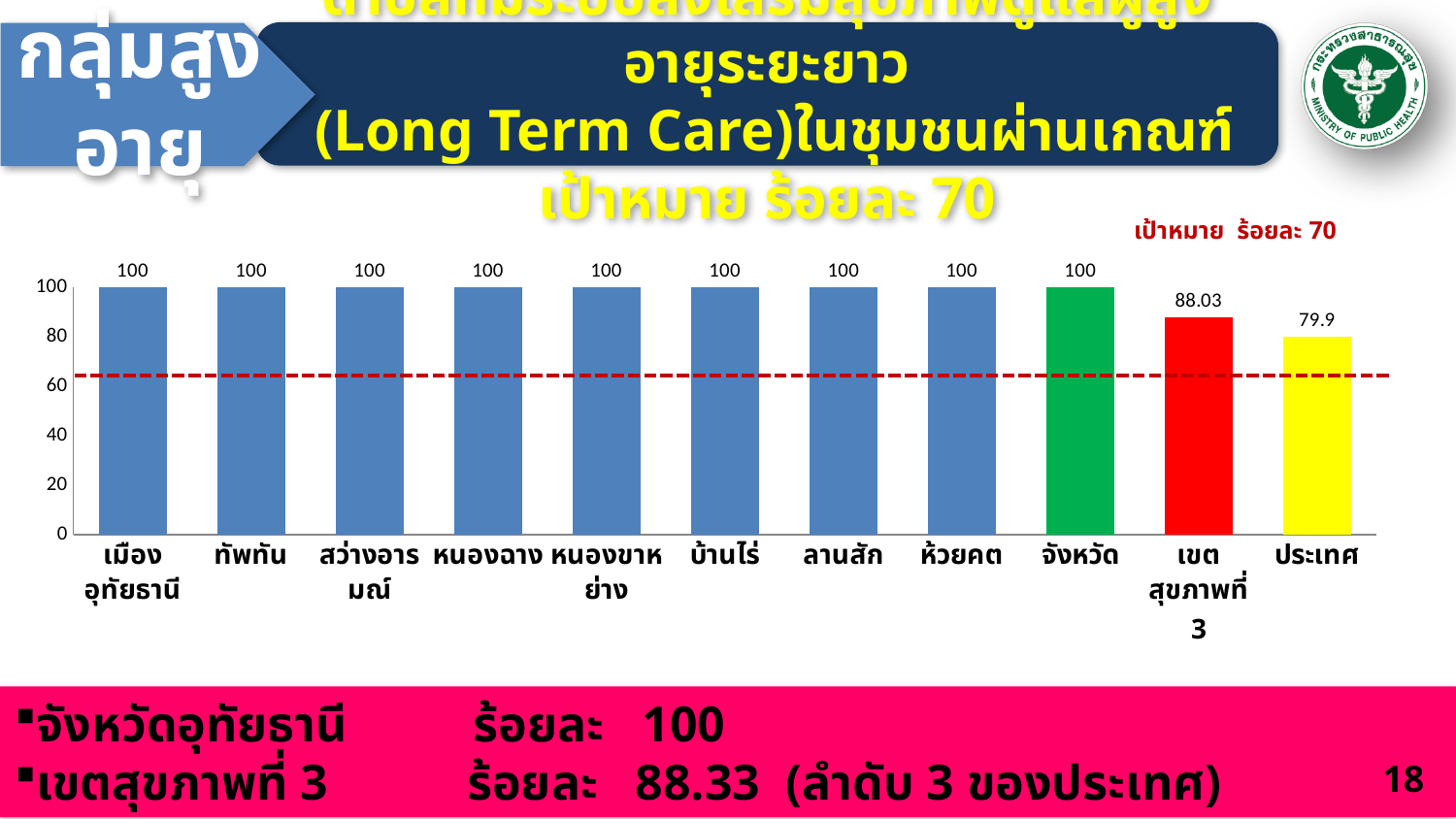
What is the value for ประเทศ? 79.9 What colour is the bar for จังหวัด? green What is the difference between the values for เขตสุขภาพที่ 3 and ประเทศ? 8.13 What kind of chart is shown on the slide? bar chart What is the value for ทัพทัน? 100 What is the difference between the values for จังหวัด and เขตสุขภาพที่ 3? 11.97 Which is larger, the value for เขตสุขภาพที่ 3 or the value for ประเทศ? เขตสุขภาพที่ 3 Is the value for ประเทศ greater or less than 60? greater What is the value for จังหวัด? 100 How many categories are shown on the x axis? 11 Which category has the lowest value? ประเทศ What is the value for เขตสุขภาพที่ 3? 88.03